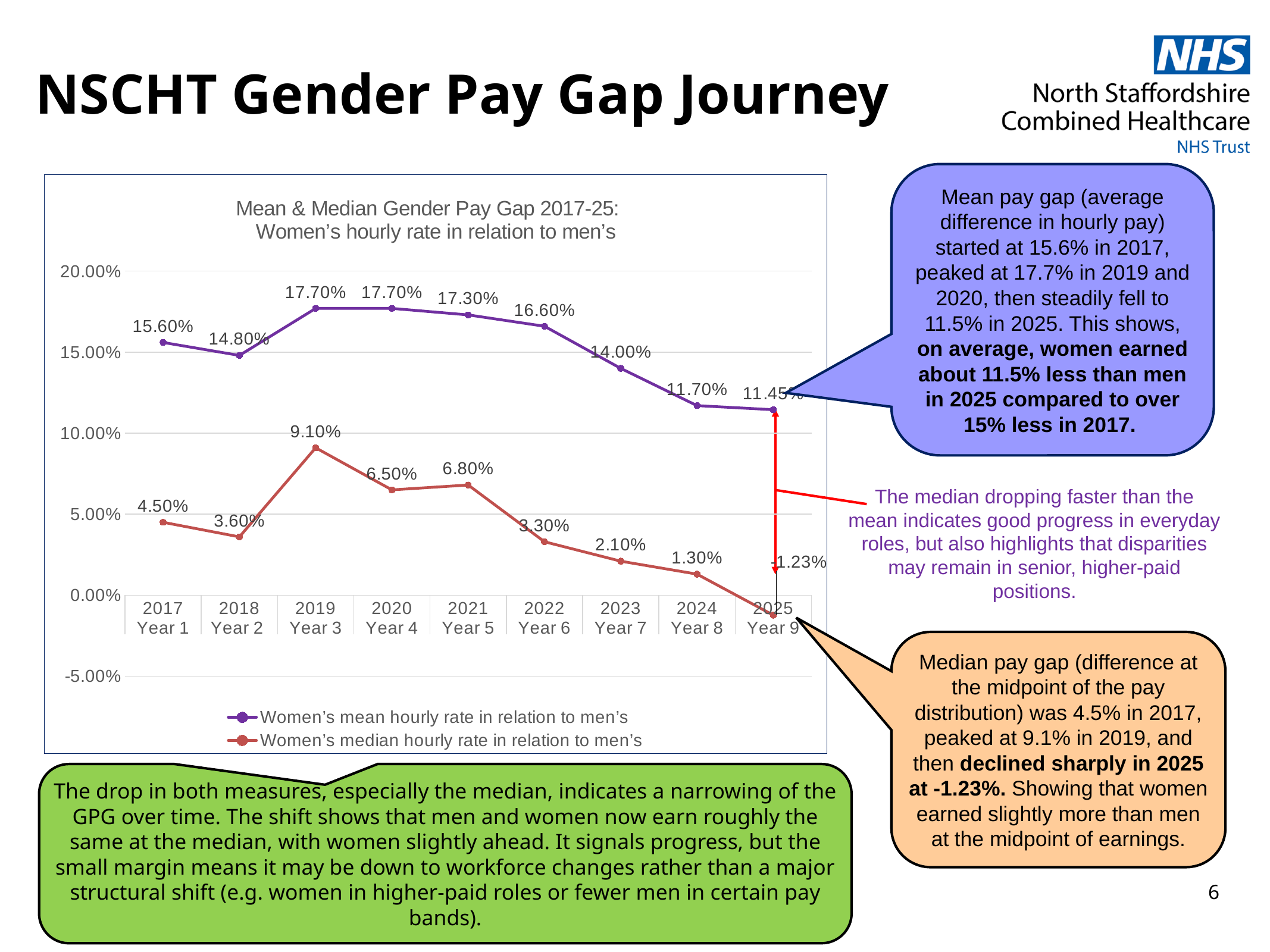
In which year does the median series reach its highest value? 2019 (Year 3) Which is larger in 2021: the mean value or the median value? The mean value (17.30%) How many years (data points) are plotted on the x axis? 9 What is the value of women's median hourly rate in relation to men's in 2025 (Year 9)? -1.23% What type of chart is shown on the slide? Line chart What is the value of women's mean hourly rate in relation to men's in 2017 (Year 1)? 15.60% What is the title of the chart? Mean & Median Gender Pay Gap 2017-25: Women's hourly rate in relation to men's What is the difference between the mean value in 2019 (17.70%) and the mean value in 2025 (11.45%)? 6.25% How many series does the chart legend list? 2 Does the mean series rise or fall between 2020 and 2025? Fall In which year is the mean series at its lowest value? 2025 (Year 9) What is the value of women's median hourly rate in relation to men's in 2022 (Year 6)? 3.30%